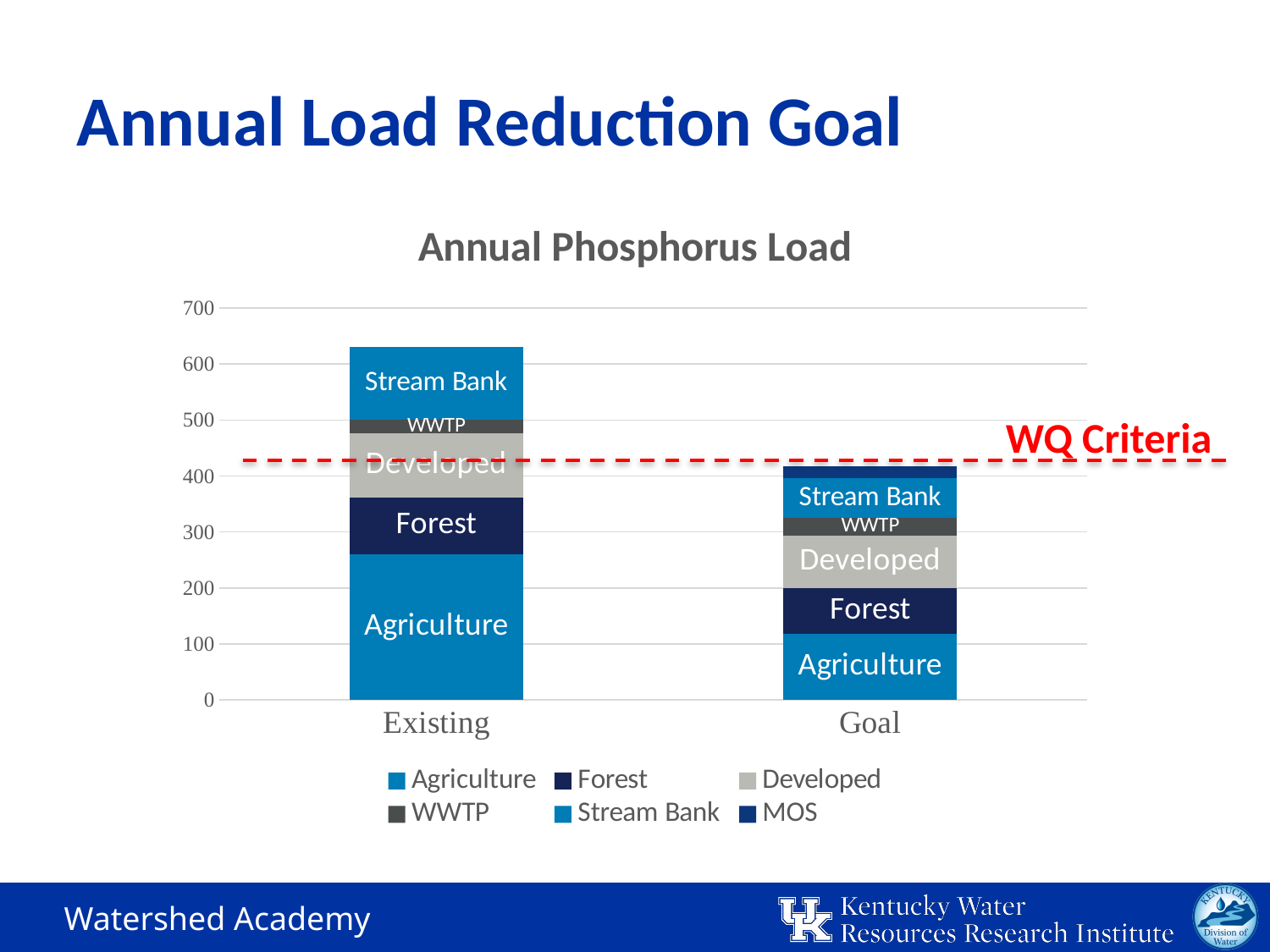
Is the total value of the Goal bar greater or less than 500? less Which category has the higher total annual phosphorus load, Existing or Goal? Existing What does the red dashed horizontal line across the chart represent? WQ Criteria Is the Agriculture segment of the Existing bar greater or less than 200? greater How many categories are shown on the x axis of the chart? 2 Which category has the lowest total bar in the chart? Goal Is the Agriculture segment of the Goal bar greater or less than 200? less How many series does the chart's legend list? 6 What type of chart is shown on the slide? Stacked bar chart What is the title of the chart? Annual Phosphorus Load Do the total bar values rise or fall from Existing to Goal? fall